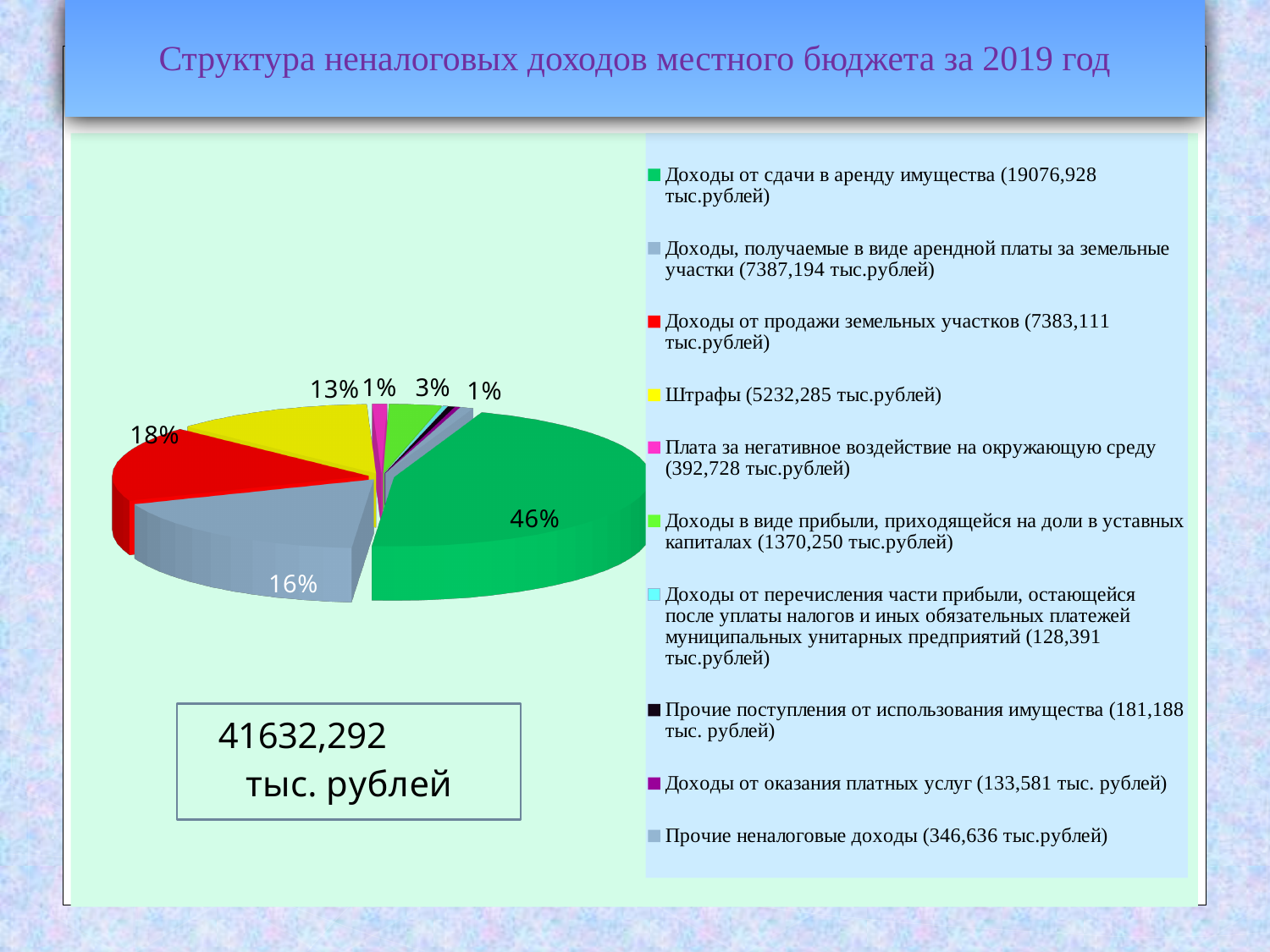
What share of the pie does Доходы от сдачи в аренду имущества have? 46% How many categories does the legend of the pie chart list? 10 What share of the pie does Штрафы have? 13% What total amount is shown in the box below the pie chart? 41632,292 тыс. рублей Which category has the smallest value in the legend? Доходы от перечисления части прибыли, остающейся после уплаты налогов и иных обязательных платежей муниципальных унитарных предприятий What is the title of the slide with the pie chart? Структура неналоговых доходов местного бюджета за 2019 год What value is given in the legend for Штрафы? 5232,285 тыс.рублей What value is given in the legend for Доходы от оказания платных услуг? 133,581 тыс. рублей Which category has the largest slice of the pie chart? Доходы от сдачи в аренду имущества What kind of chart is shown on the slide? pie chart What share of the pie does Доходы от продажи земельных участков have? 18% Which has a larger share of the pie: Штрафы or Плата за негативное воздействие на окружающую среду? Штрафы